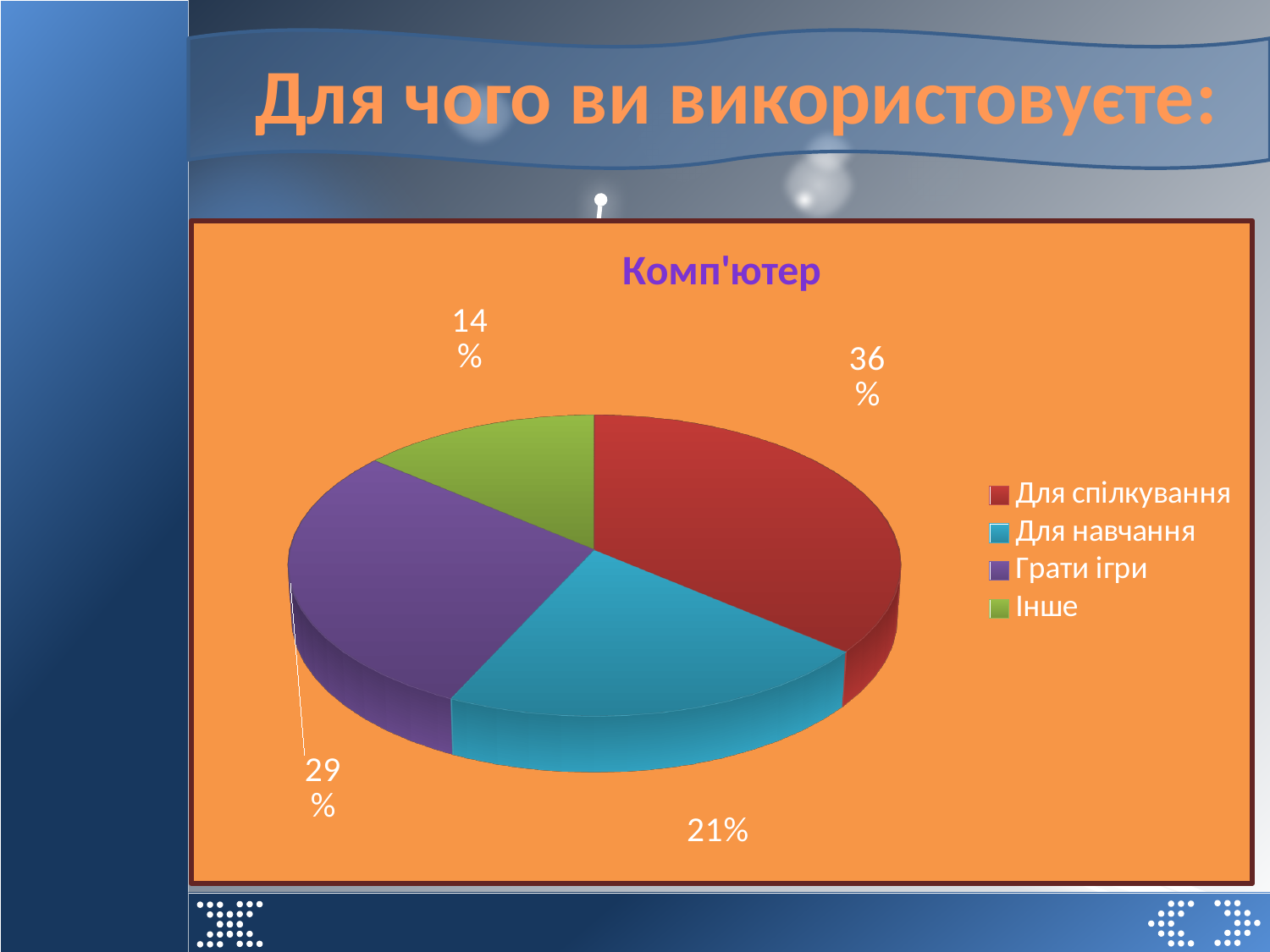
Which category has the smallest slice of the pie? Інше What is the difference in percentage points between "Для спілкування" and "Інше"? 22 What percentage of the pie is labelled for "Для спілкування"? 36% What colour is the slice for "Грати ігри"? purple What percentage of the pie is labelled for "Для навчання"? 21% How many slices does the pie chart have? 4 What type of chart is shown on the slide? pie chart Which category has the largest slice of the pie? Для спілкування What is the title of the chart? Комп'ютер What percentage of the pie is labelled for "Грати ігри"? 29% Which is larger, the slice for "Грати ігри" or the slice for "Для навчання"? Грати ігри What percentage of the pie is labelled for "Інше"? 14%